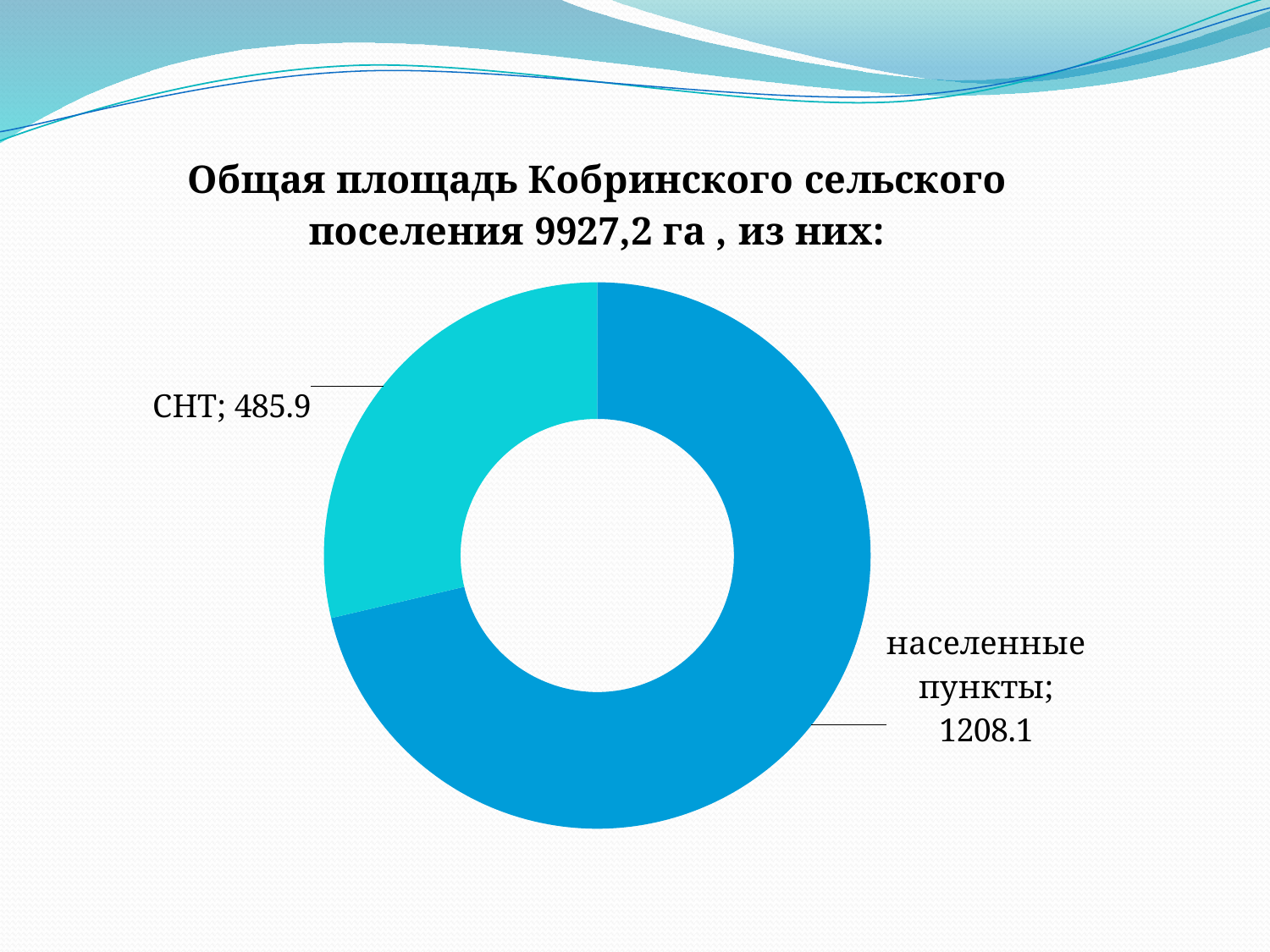
What is the difference between the values for населенные пункты and СНТ? 722.2 How many categories are shown in the chart? 2 What kind of chart is shown on the slide? doughnut chart What value is shown for СНТ? 485.9 Which is larger, the value for СНТ or the value for населенные пункты? населенные пункты Which category has the largest slice? населенные пункты What total area in hectares is stated in the chart title? 9927,2 га Which category has the smallest slice? СНТ What is the title of the chart? Общая площадь Кобринского сельского поселения 9927,2 га , из них: What is the total of the two values shown in the chart? 1694.0 What value is shown for населенные пункты? 1208.1